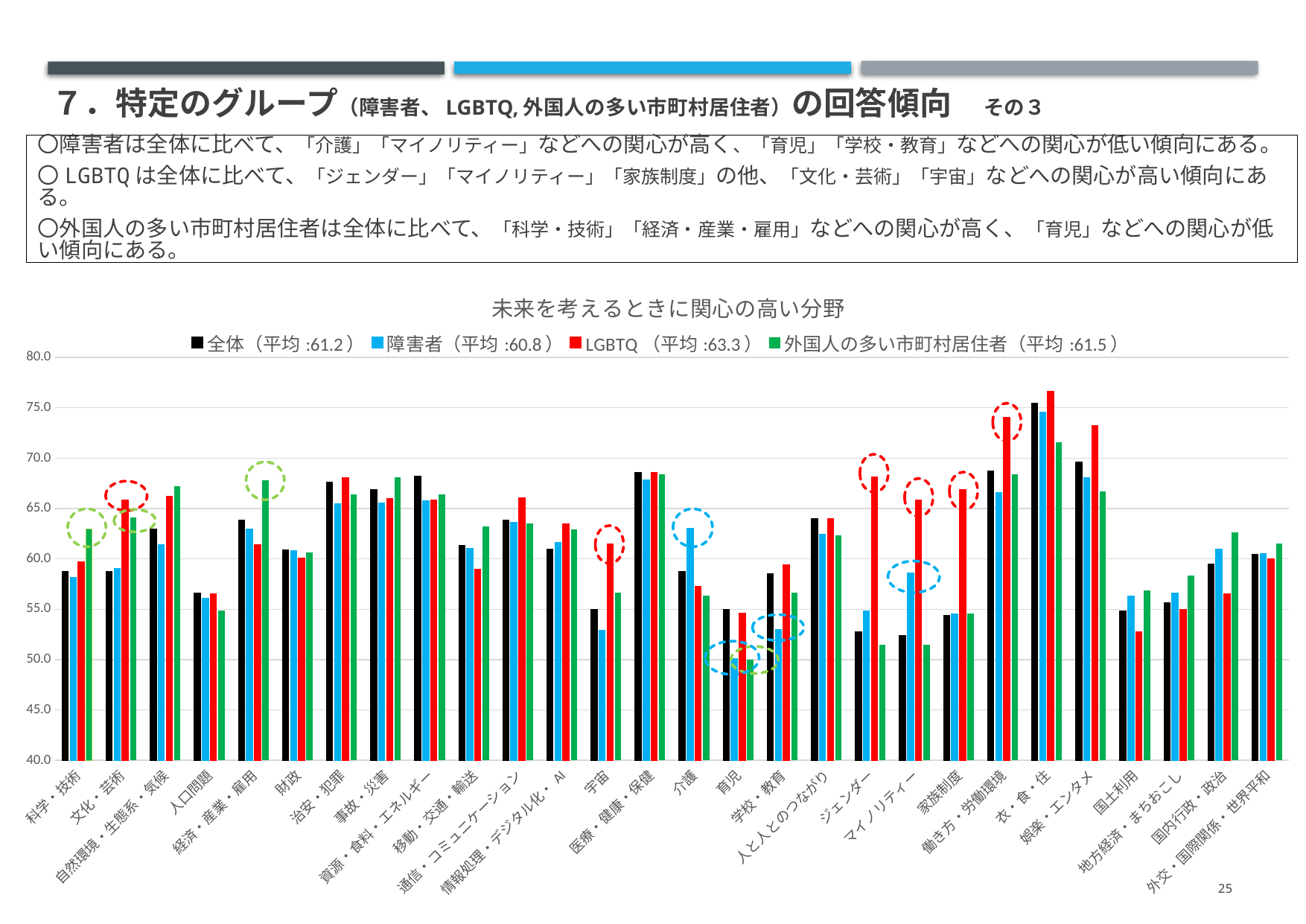
What is the title of the chart? 未来を考えるときに関心の高い分野 How many series does the legend list? 4 How many categories are shown along the x axis? 28 According to the legend, what is the average (平均) for the LGBTQ series? 63.3 Which category has the highest value for the LGBTQ series? 衣・食・住 Which category has the highest value for the 全体 series? 衣・食・住 Is the value for 全体 at 衣・食・住 greater or less than 70? greater What kind of chart is shown on the slide? bar chart Is the value for 外国人の多い市町村居住者 at 経済・産業・雇用 greater or less than 65? greater At ジェンダー, which is larger: the value for LGBTQ or the value for 全体? LGBTQ At 介護, which is larger: the value for 障害者 or the value for 全体? 障害者 Is the value for 障害者 at 宇宙 greater or less than 55? less